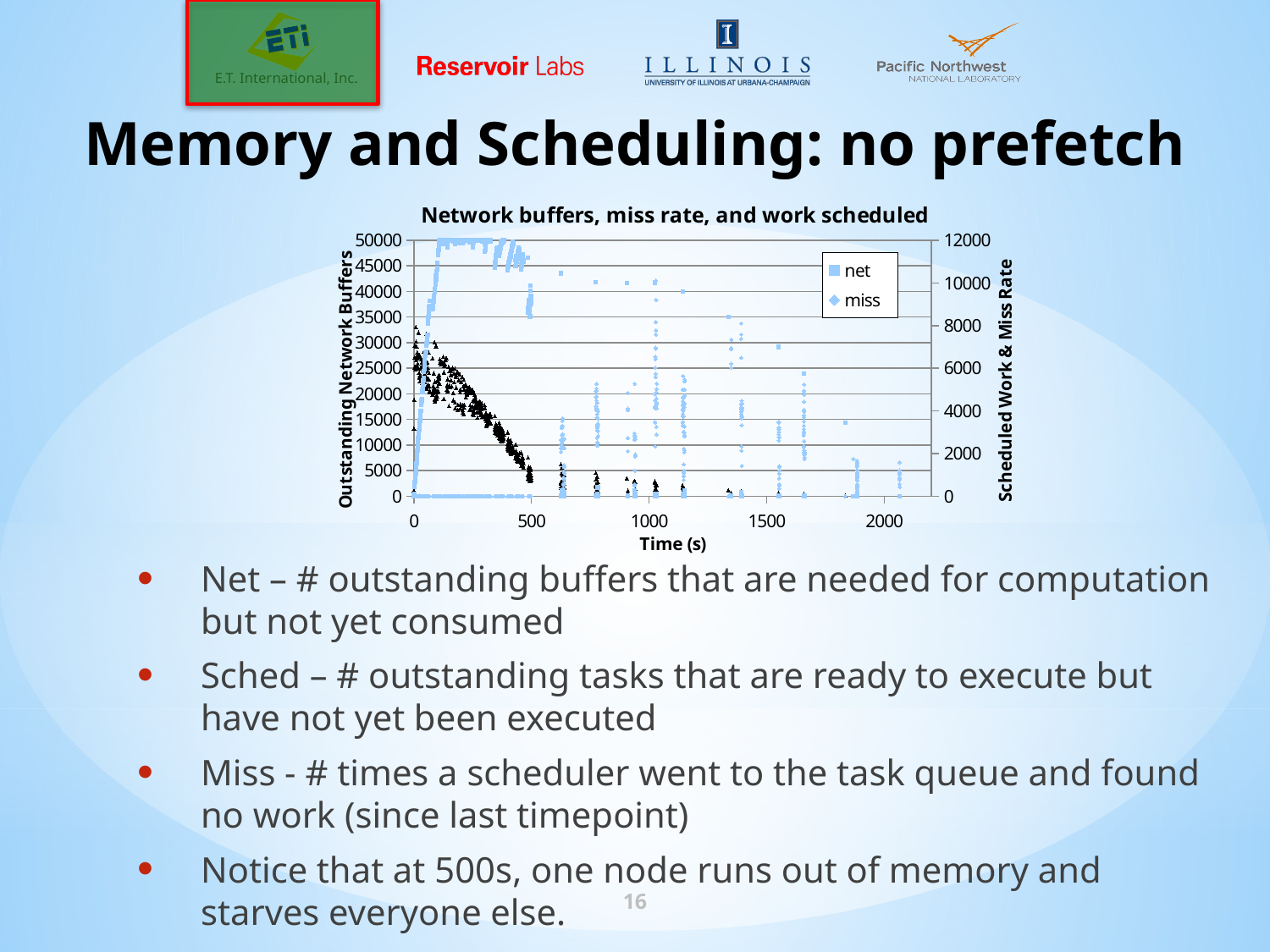
What is the title of the chart? Network buffers, miss rate, and work scheduled What is the label of the x axis of the chart? Time (s) Is the value of the net series at around 200 s greater or less than 40000 on the left axis? greater How many series does the chart's legend list? 2 What is the highest tick value shown on the left vertical axis? 50000 What kind of chart is shown on the slide? scatter chart